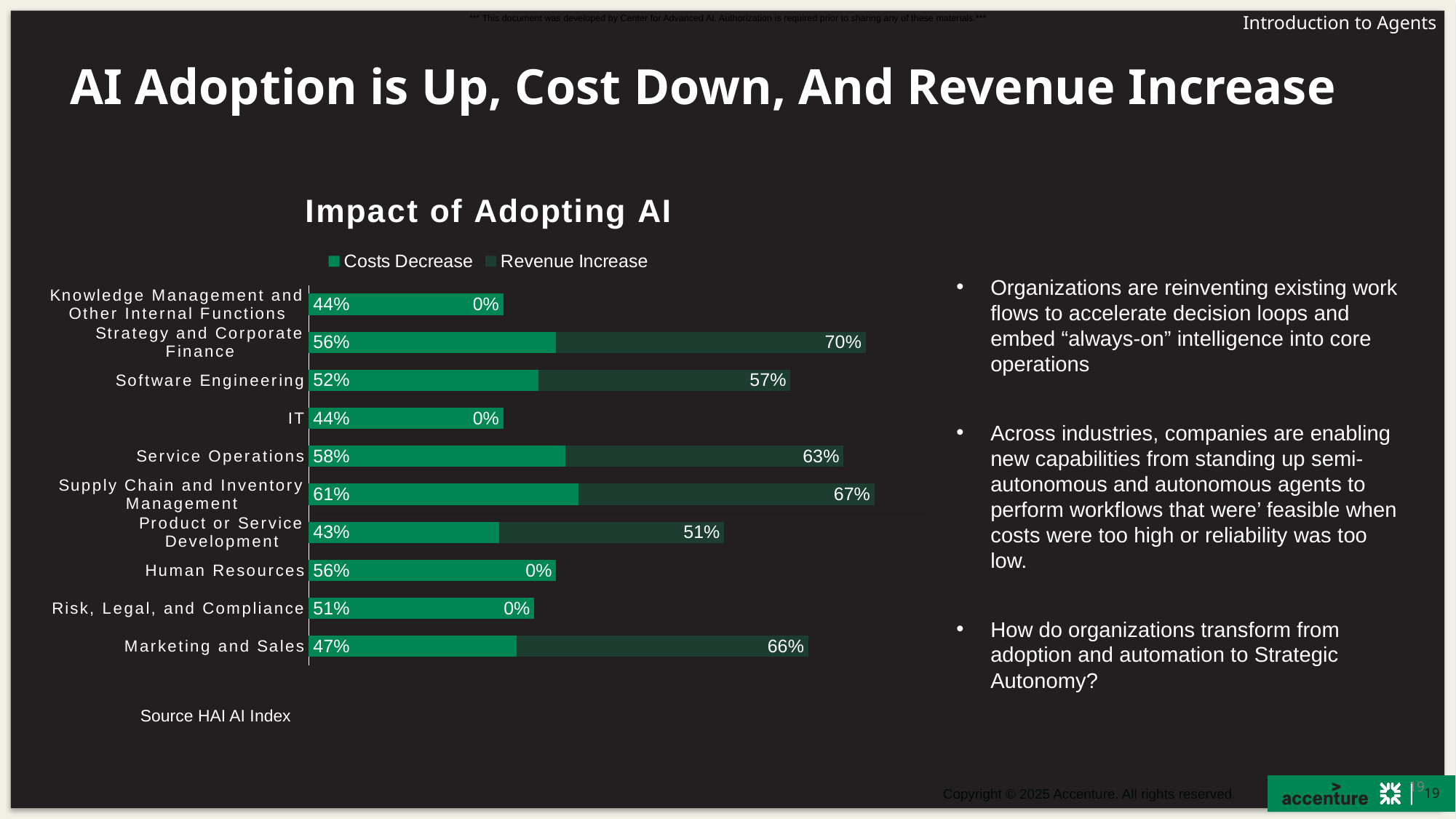
What is the difference between the Revenue Increase and Costs Decrease values for Strategy and Corporate Finance? 14% What is the Revenue Increase value for Marketing and Sales? 66% Which category has the lowest Costs Decrease value? Product or Service Development Which category has the highest Revenue Increase value? Strategy and Corporate Finance How many series does the legend list? 2 What is the title of the chart? Impact of Adopting AI What is the Costs Decrease value for Supply Chain and Inventory Management? 61% What kind of chart is shown on the slide? Bar chart How many categories are shown in the chart? 10 Which category has the highest Costs Decrease value? Supply Chain and Inventory Management Which is larger: the Costs Decrease value for Service Operations or for Software Engineering? Service Operations What is the Revenue Increase value for Human Resources? 0%